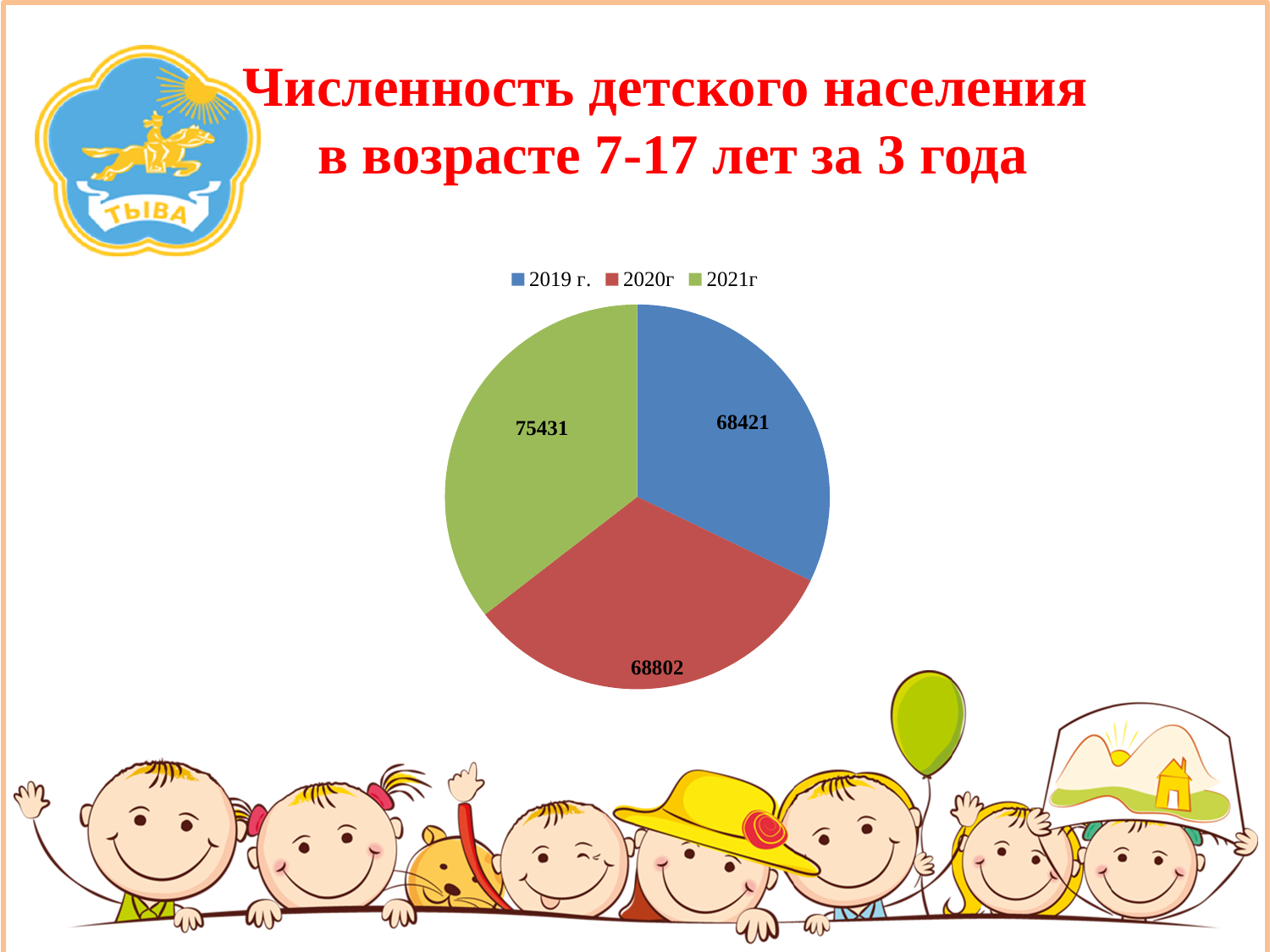
How many entries does the legend list? 3 What is the value for 2020г in the pie chart? 68802 What colour is the slice for 2020г? red What is the difference between the values for 2020г and 2019 г.? 381 What is the value for 2019 г. in the pie chart? 68421 What type of chart is shown on the slide? pie chart Which is larger, the value for 2021г or the value for 2020г? 2021г What is the value for 2021г in the pie chart? 75431 Which year has the smallest slice in the pie chart? 2019 г. Which year has the largest slice in the pie chart? 2021г How many slices does the pie chart have? 3 What is the difference between the values for 2021г and 2019 г.? 7010